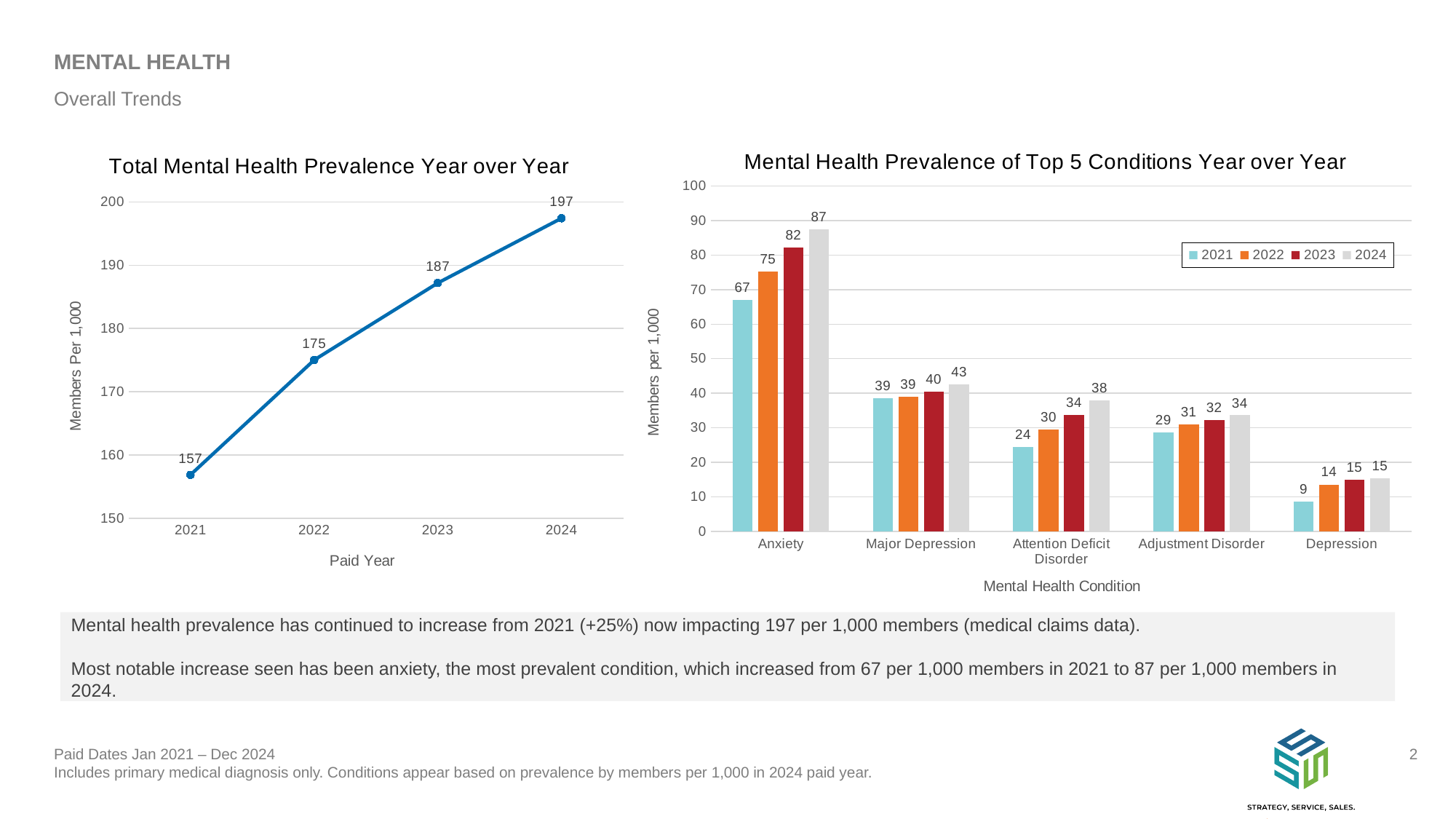
In the 'Total Mental Health Prevalence Year over Year' chart, what is the difference between the 2024 and 2021 values? 40 In the 'Mental Health Prevalence of Top 5 Conditions Year over Year' chart, which condition has the highest 2024 value? Anxiety In the 'Total Mental Health Prevalence Year over Year' chart, what is the value for 2022? 175 In the 'Mental Health Prevalence of Top 5 Conditions Year over Year' chart, how many series does the legend list? 4 In the 'Mental Health Prevalence of Top 5 Conditions Year over Year' chart, what is the difference between the 2024 and 2021 values for Anxiety? 20 What kind of chart is 'Total Mental Health Prevalence Year over Year'? line chart In the 'Mental Health Prevalence of Top 5 Conditions Year over Year' chart, which condition has the lowest 2021 value? Depression In the 'Mental Health Prevalence of Top 5 Conditions Year over Year' chart, which is larger: the 2024 value for Major Depression or the 2024 value for Attention Deficit Disorder? Major Depression In the 'Mental Health Prevalence of Top 5 Conditions Year over Year' chart, what is the 2023 value for Attention Deficit Disorder? 34 In the 'Total Mental Health Prevalence Year over Year' chart, do the values rise or fall from 2021 to 2024? rise What kind of chart is 'Mental Health Prevalence of Top 5 Conditions Year over Year'? bar chart In the 'Total Mental Health Prevalence Year over Year' chart, how many years are plotted? 4